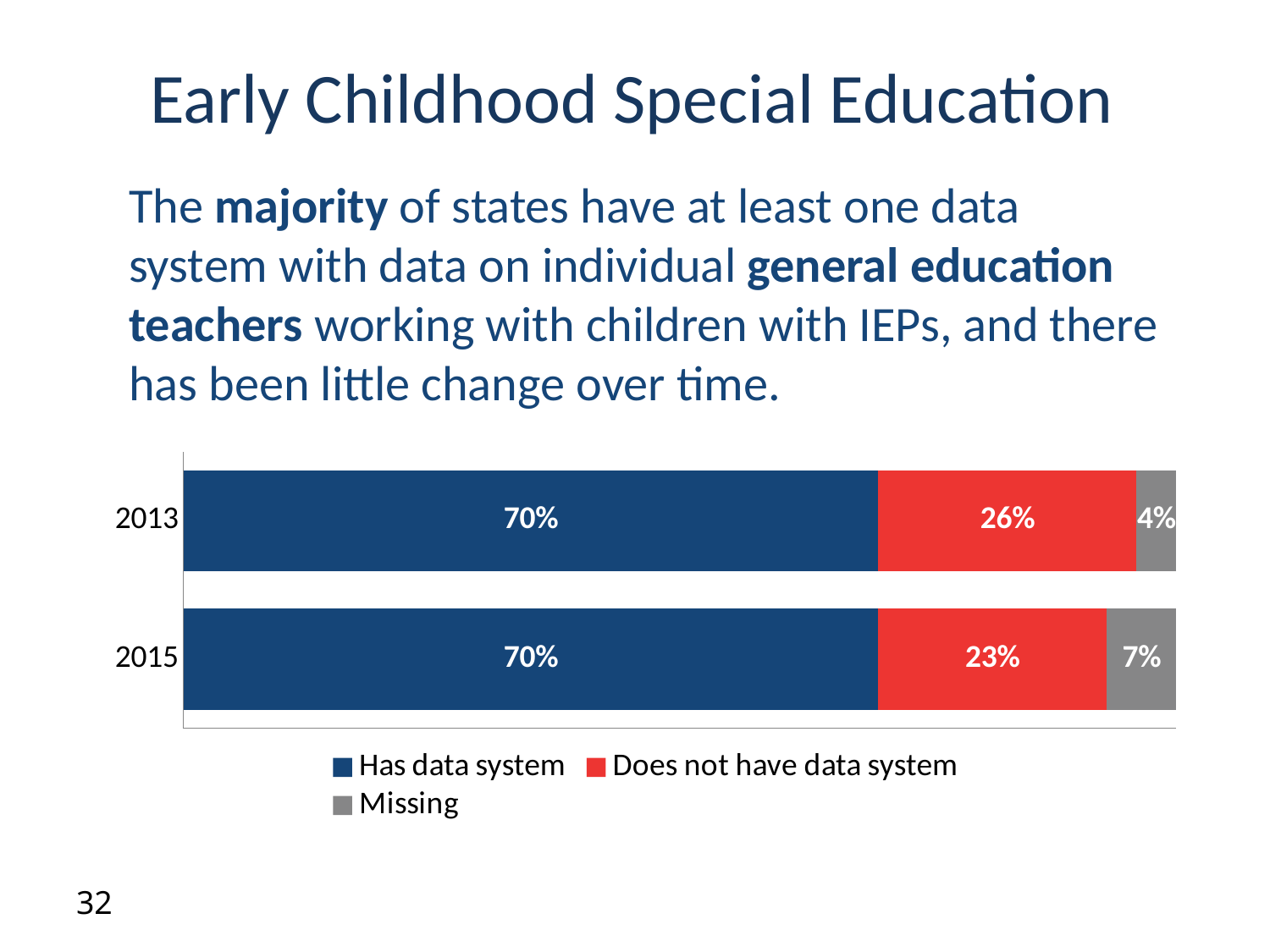
Which year has the larger 'Does not have data system' share, 2013 or 2015? 2013 What is the total of the stacked bar for 2015? 100% How many series does the legend list? 3 Which legend entry is shown in red? Does not have data system Which year has the larger Missing share, 2013 or 2015? 2015 What percentage of states had a data system in 2013? 70% What kind of chart is shown on the slide? Stacked bar chart What is the difference between the 'Does not have data system' values for 2013 and 2015? 3% How many years (categories) are shown in the chart? 2 What is the Missing value for 2015? 7% What is the Missing value for 2013? 4% What percentage of states did not have a data system in 2015? 23%